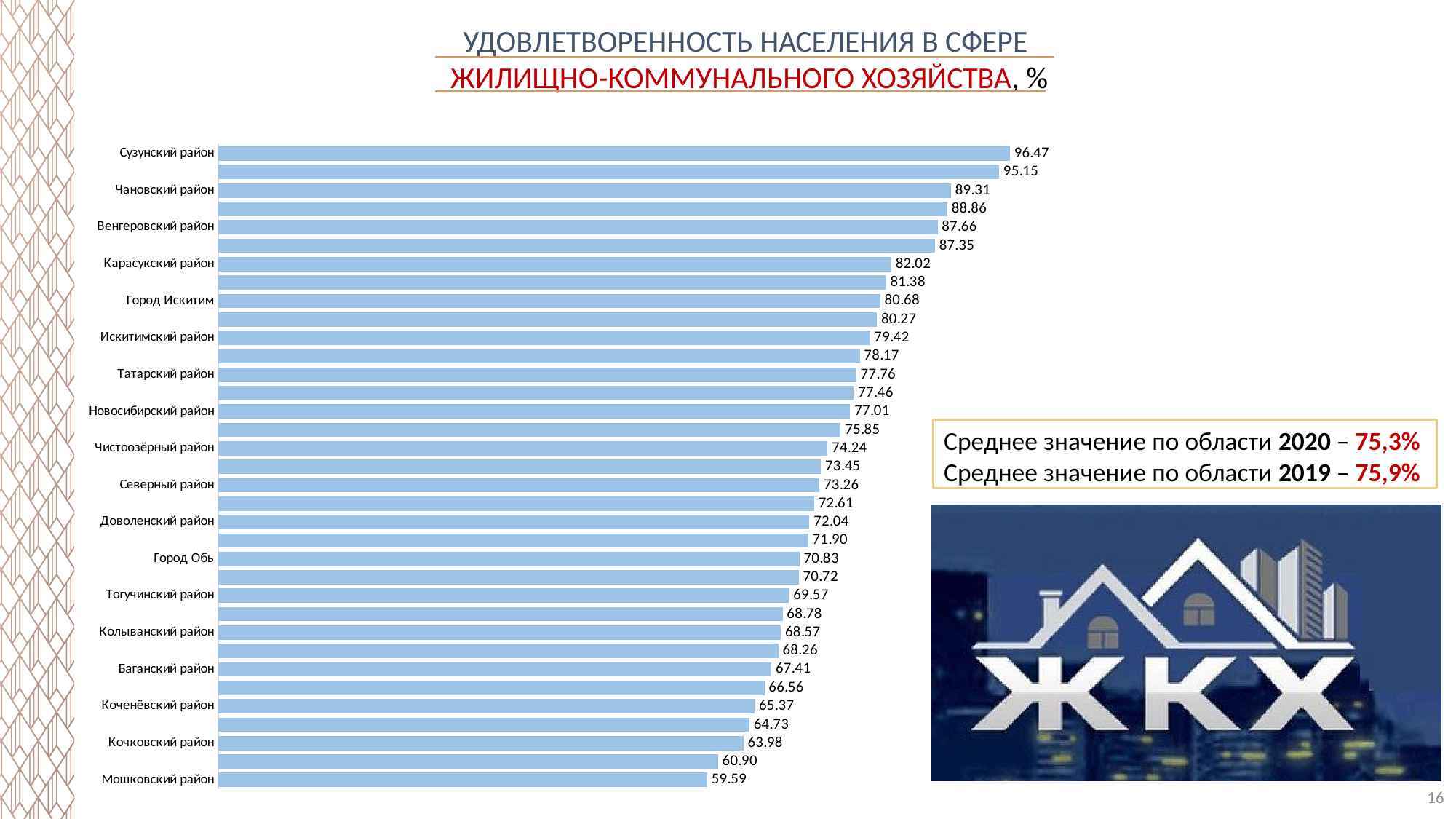
What is the difference between the values for Сузунский район and Мошковский район? 36.88 Which is larger, the value for Чановский район or the value for Венгеровский район? Чановский район Do the bar values increase or decrease going from the top of the chart to the bottom? decrease According to the text box on the slide, what was the regional average value in 2020? 75,3% What is the value for Новосибирский район? 77.01 What is the value for Город Обь? 70.83 What kind of chart is shown on the slide? bar chart What is the value for Город Искитим? 80.68 What is the value for Мошковский район? 59.59 Which labelled category has the lowest value? Мошковский район What is the value for Сузунский район? 96.47 Which labelled category has the highest value? Сузунский район